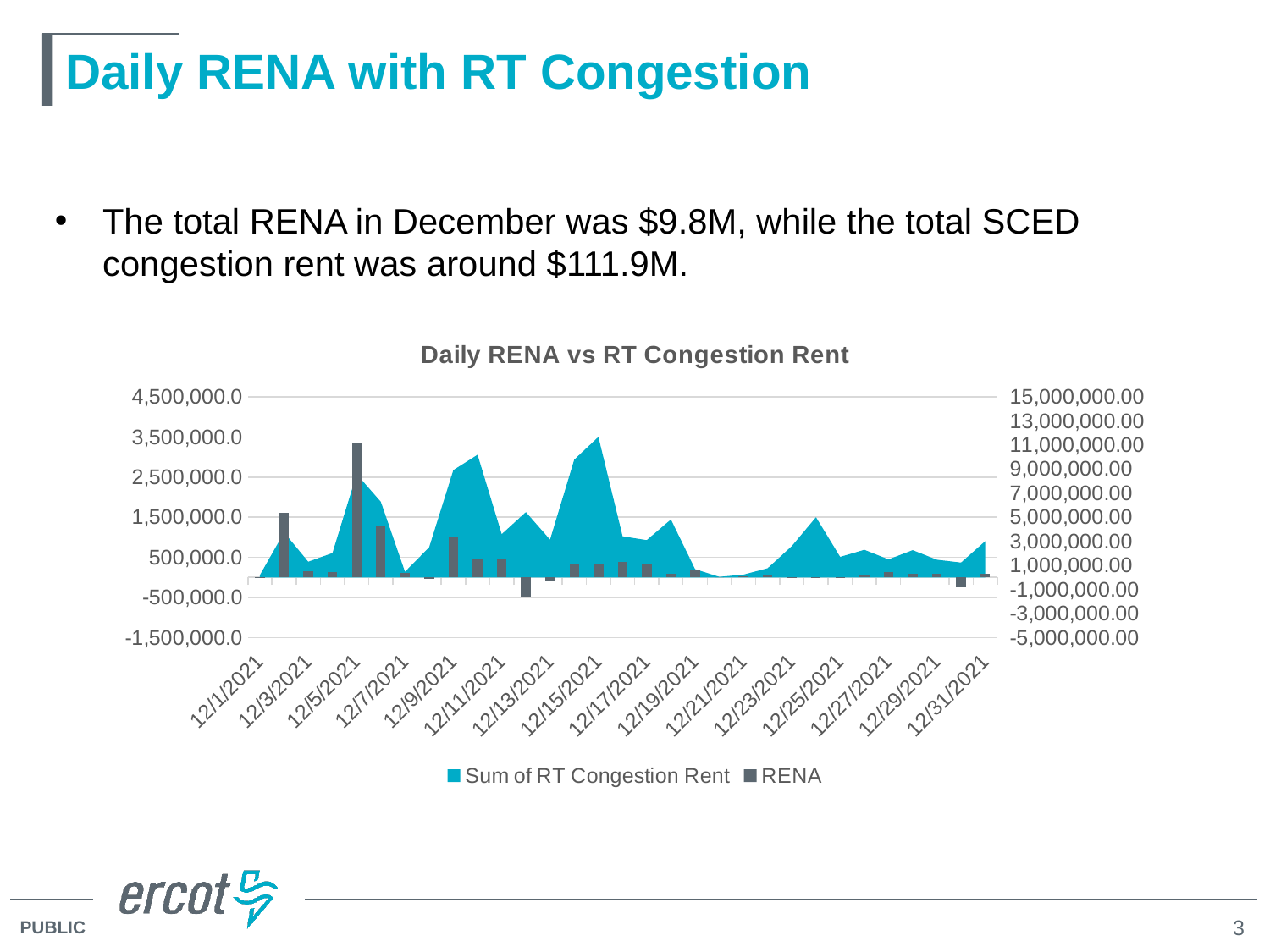
How many date labels are shown along the x axis? 16 What are the two series named in the legend? Sum of RT Congestion Rent and RENA On which date does the Sum of RT Congestion Rent reach its highest peak? 12/15/2021 What kind of chart is used to plot the RENA series? bar chart Is the RENA value on 12/5/2021 greater or less than 2,500,000.0 on the left axis? greater On which date is the RENA bar the highest? 12/5/2021 Which is larger, the RENA bar on 12/5/2021 or the RENA bar on 12/9/2021? 12/5/2021 Does the Sum of RT Congestion Rent rise or fall from 12/15/2021 to 12/21/2021? fall Is the RENA value on 12/5/2021 greater or less than 3,500,000.0 on the left axis? less Using the right-hand axis, is the Sum of RT Congestion Rent on 12/15/2021 greater or less than 9,000,000.00? greater How many series does the chart legend list? 2 What is the title of the chart? Daily RENA vs RT Congestion Rent